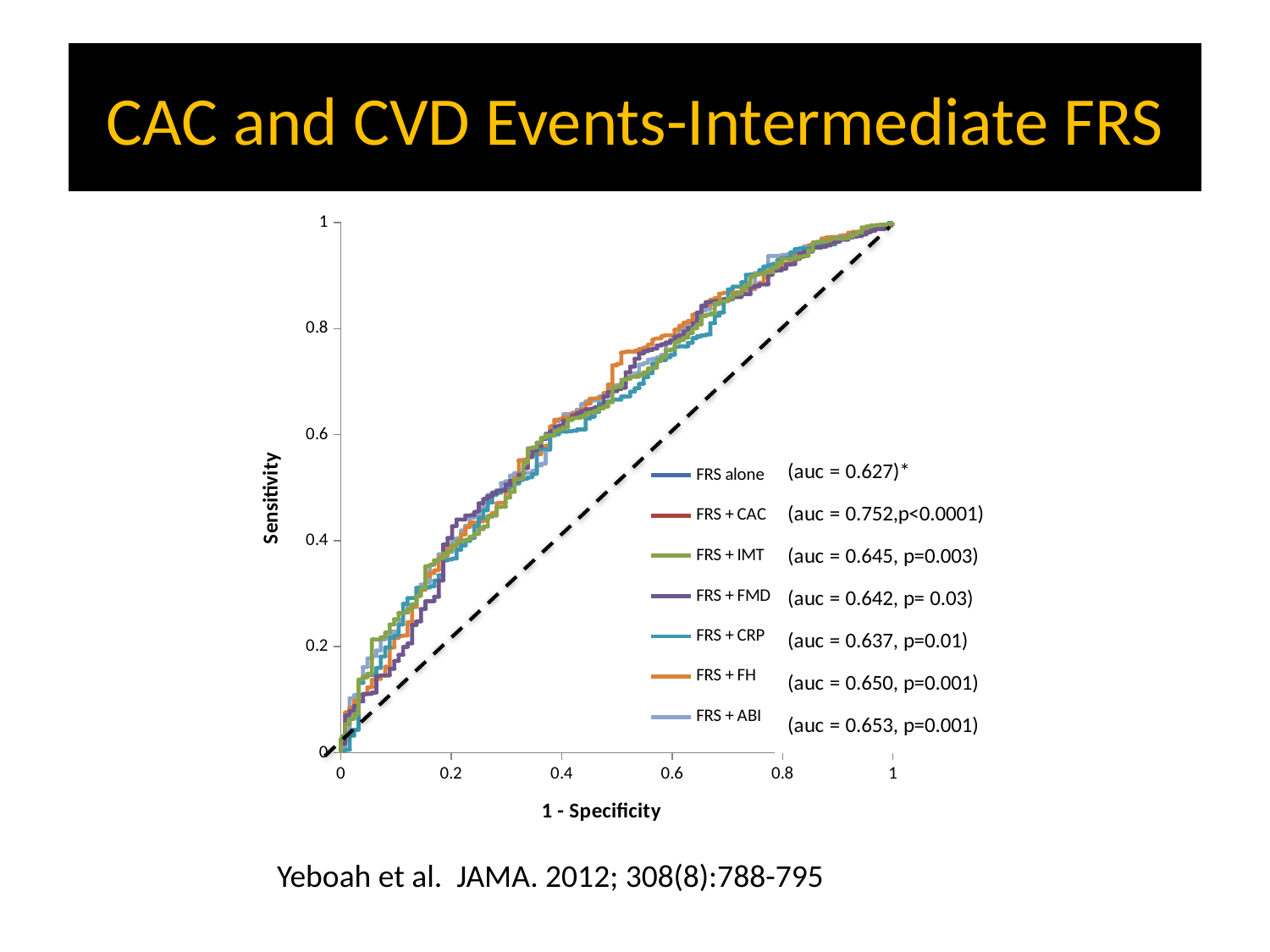
What is the label of the x axis? 1 - Specificity Which has the larger printed AUC, FRS + FH or FRS + IMT? FRS + FH Which series has the lowest printed AUC? FRS alone What kind of chart is shown on the slide? line chart What p-value is printed for FRS + CRP? p=0.01 What is the AUC printed for FRS alone? 0.627 Do the plotted curves rise or fall as 1 - Specificity increases? rise What is the AUC printed for FRS + ABI? 0.653 Which series has the highest printed AUC? FRS + CAC How many series does the legend list? 7 What is the difference between the AUC for FRS + CAC and the AUC for FRS alone? 0.125 What is the AUC printed for FRS + CAC? 0.752